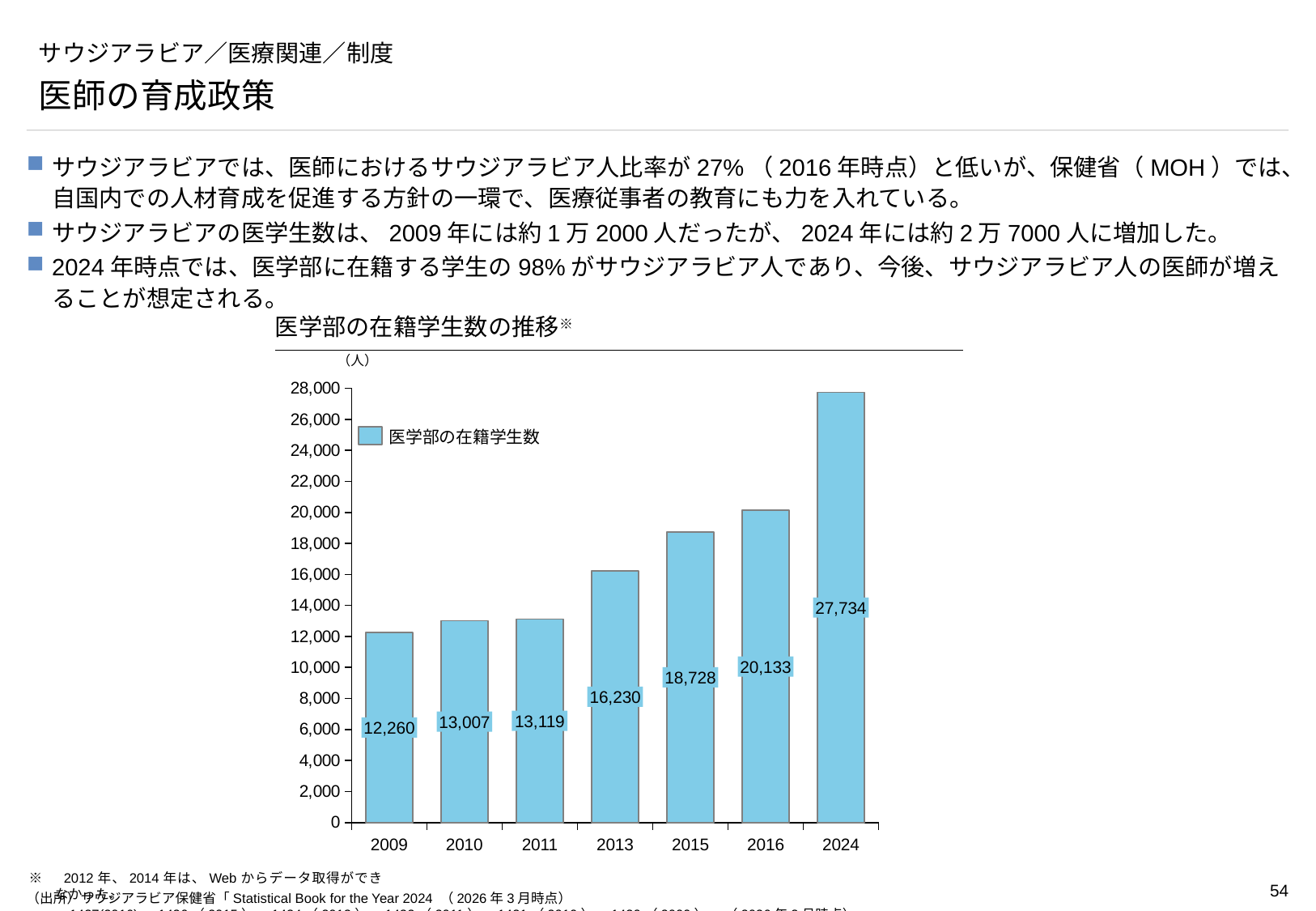
How many years are shown on the x axis? 7 What is the number of enrolled medical students in 2009? 12,260 What is the value for 2013? 16,230 What is the number of enrolled medical students in 2024? 27,734 How many series does the legend list? 1 Which is larger, the value for 2015 or the value for 2013? 2015 Which year has the highest number of enrolled medical students? 2024 What kind of chart is shown? bar chart Is the value for 2016 greater or less than 20,000? greater Do the values rise or fall from 2009 to 2024? rise Which year has the lowest number of enrolled medical students? 2009 What is the difference between the values for 2024 and 2016? 7,601